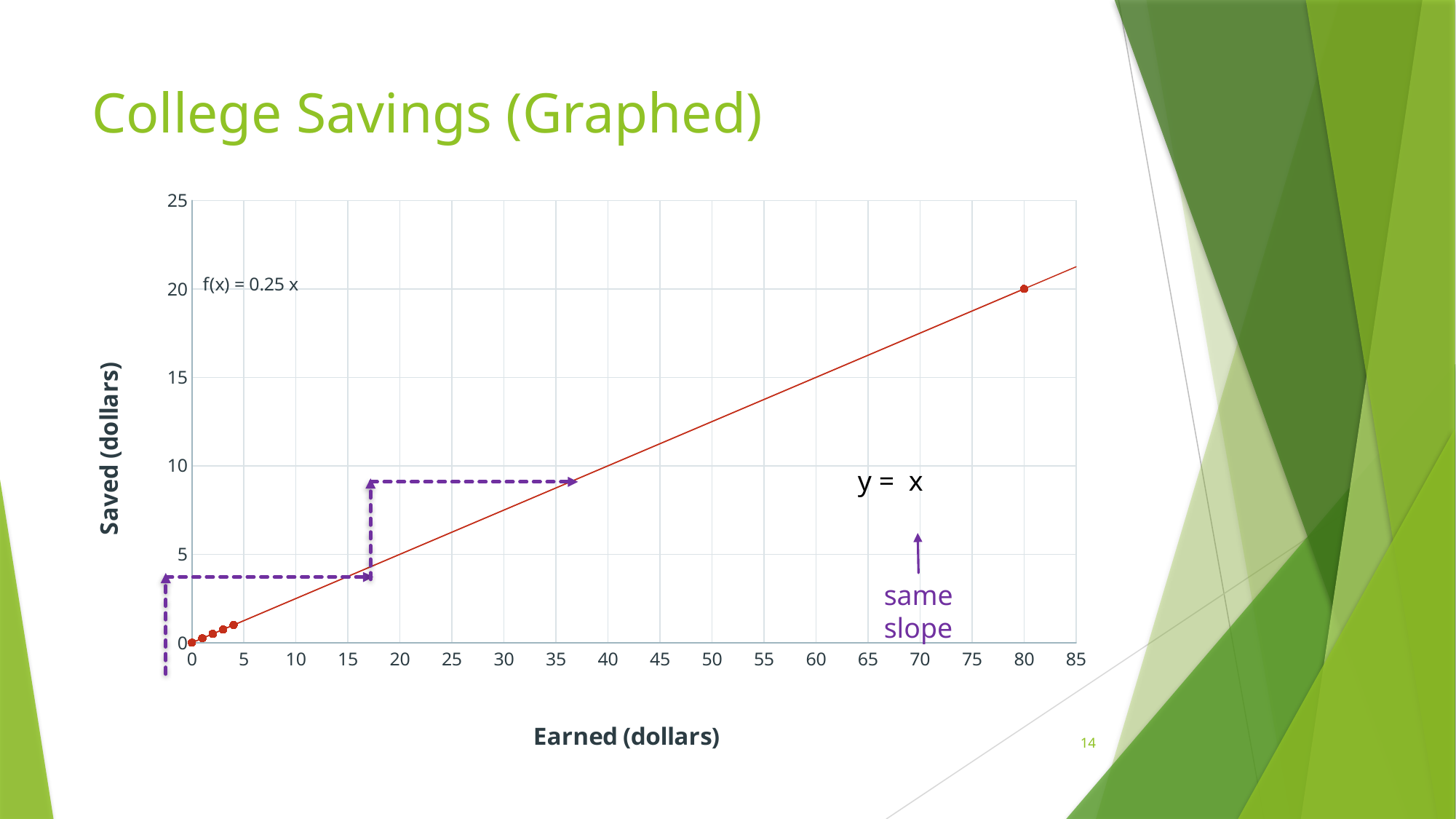
What is the label of the horizontal axis? Earned (dollars) Is the saved value at 20 dollars earned greater or less than 10? less How many dollars are saved when 80 dollars are earned? 20 What kind of chart is shown on the slide? scatter chart What function is written on the chart? f(x) = 0.25 x How many dollars are saved when 0 dollars are earned? 0 At which earned amount is the plotted saved value highest? 80 Is the saved value at 40 dollars earned greater or less than 15? less How many data points are plotted on the chart? 6 Is the saved value at 60 dollars earned greater or less than 10? greater What is the title of the chart on the slide? College Savings (Graphed) Do the saved values rise or fall as earned dollars increase? rise